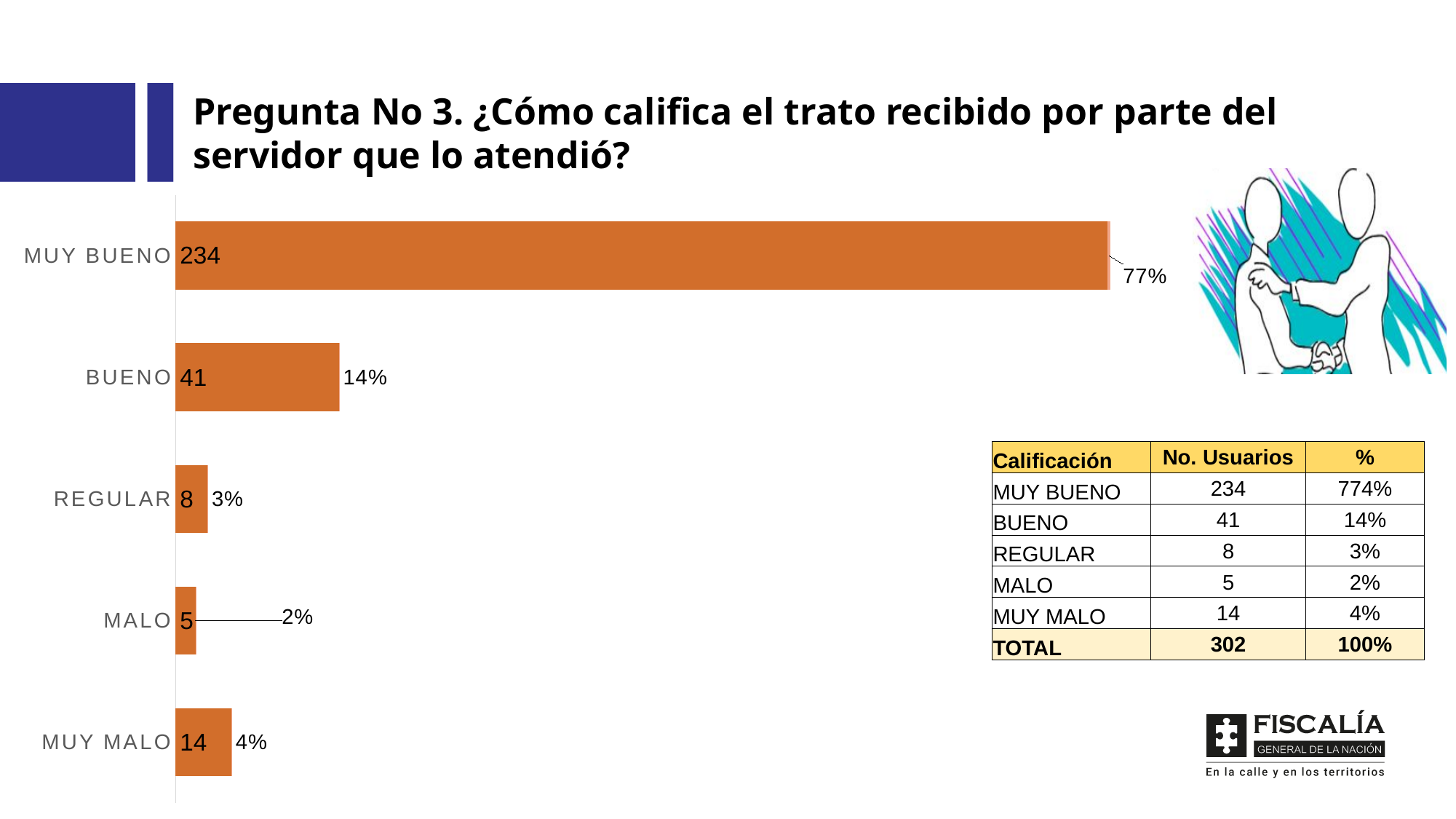
What value is shown for BUENO in the bar chart? 41 Which is larger, the value for MUY MALO or the value for REGULAR? MUY MALO What percentage label is shown next to the MUY MALO bar? 4% Which category has the lowest value in the bar chart? MALO What value is shown for MUY BUENO in the bar chart? 234 What kind of chart is shown on the slide? Bar chart What is the difference between the values for MUY BUENO and BUENO? 193 What percentage label is shown next to the MUY BUENO bar? 77% What colour are the bars in the chart? Orange Which category has the highest value in the bar chart? MUY BUENO How many categories are shown in the bar chart? 5 What is the difference between the values for MUY MALO and REGULAR? 6